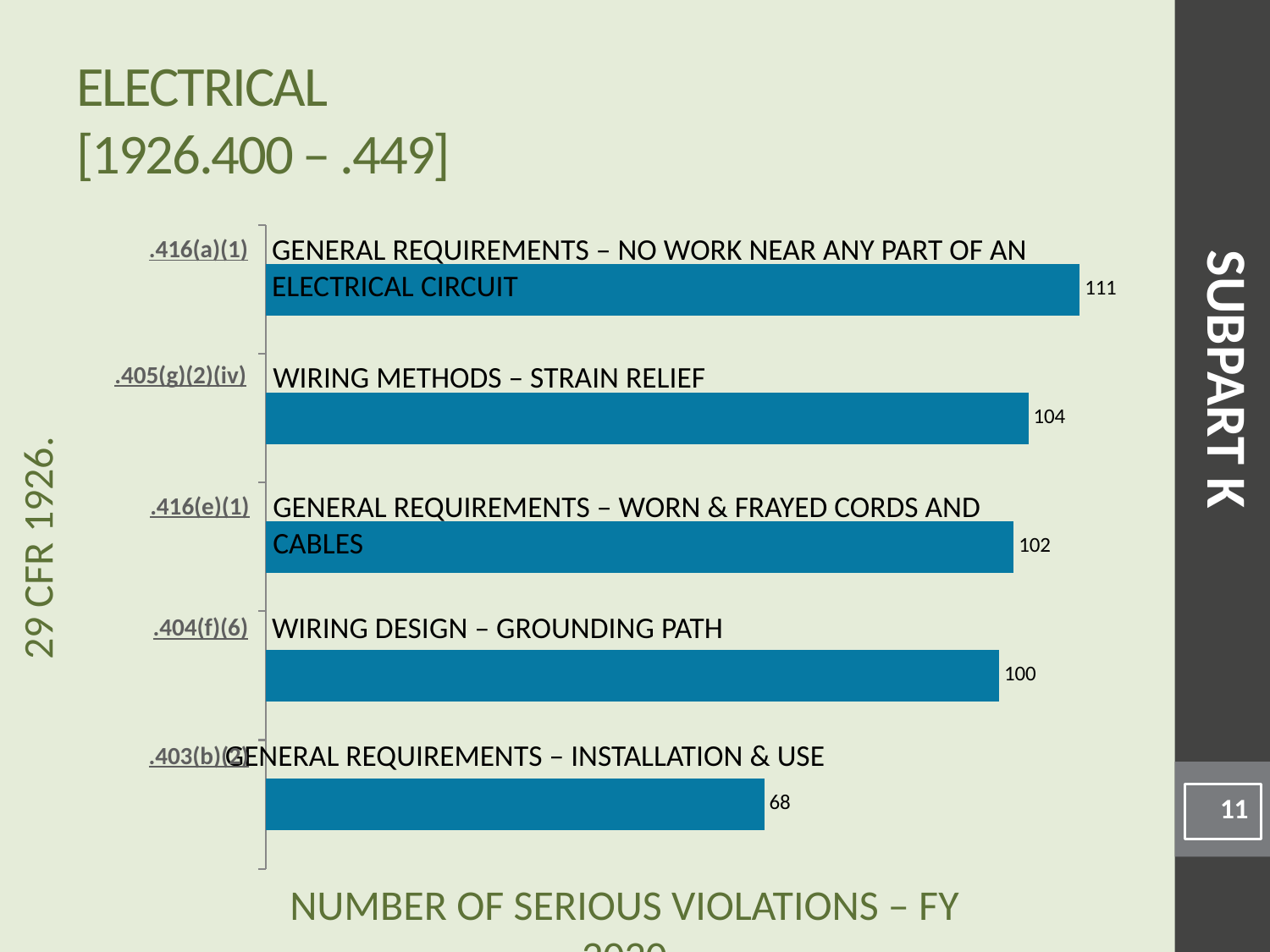
What is the value for .405(g)(2)(iv), Wiring Methods – Strain Relief? 104 Which category has the lowest number of serious violations? General Requirements – Installation & Use How many serious violations are shown for .416(a)(1), General Requirements – No Work Near Any Part of an Electrical Circuit? 111 What type of chart is shown on the slide? Bar chart What is the value for .404(f)(6), Wiring Design – Grounding Path? 100 What is the difference between the values for .405(g)(2)(iv) and General Requirements – Installation & Use? 36 How many categories are shown in the chart? 5 Which has a larger value: Wiring Methods – Strain Relief or Wiring Design – Grounding Path? Wiring Methods – Strain Relief What is the value for General Requirements – Installation & Use? 68 What is the difference between the values for .416(a)(1) and .404(f)(6)? 11 What is the value for .416(e)(1), General Requirements – Worn & Frayed Cords and Cables? 102 Which category has the highest number of serious violations? .416(a)(1) General Requirements – No Work Near Any Part of an Electrical Circuit